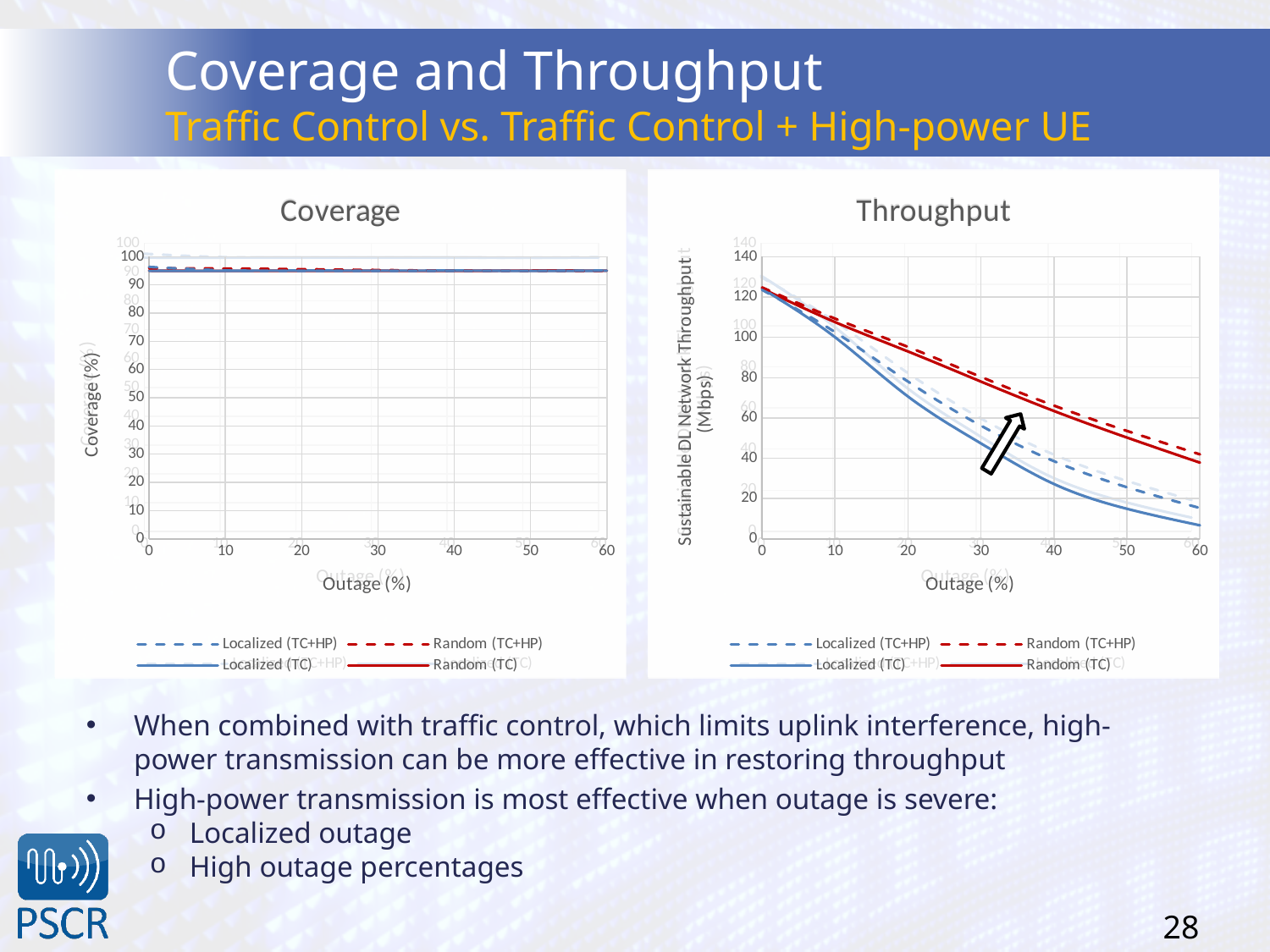
In the Throughput chart, at 60% outage, which is larger: Random (TC) or Localized (TC)? Random (TC) In the Throughput chart, at 60% outage, which is larger: Random (TC+HP) or Localized (TC+HP)? Random (TC+HP) What kind of chart is the Throughput chart? line chart How many series does the legend of the Throughput chart list? 4 What kind of chart is the Coverage chart? line chart In the Throughput chart, is the value for Random (TC) at 0% outage greater or less than 100? greater In the Throughput chart, is the value for Localized (TC) at 30% outage greater or less than 60? less In the Throughput chart, is the value for Localized (TC) at 60% outage greater or less than 20? less What is the y-axis label of the Throughput chart? Sustainable DL Network Throughput (Mbps) In the Throughput chart, do the values rise or fall as Outage (%) increases? fall How many series does the legend of the Coverage chart list? 4